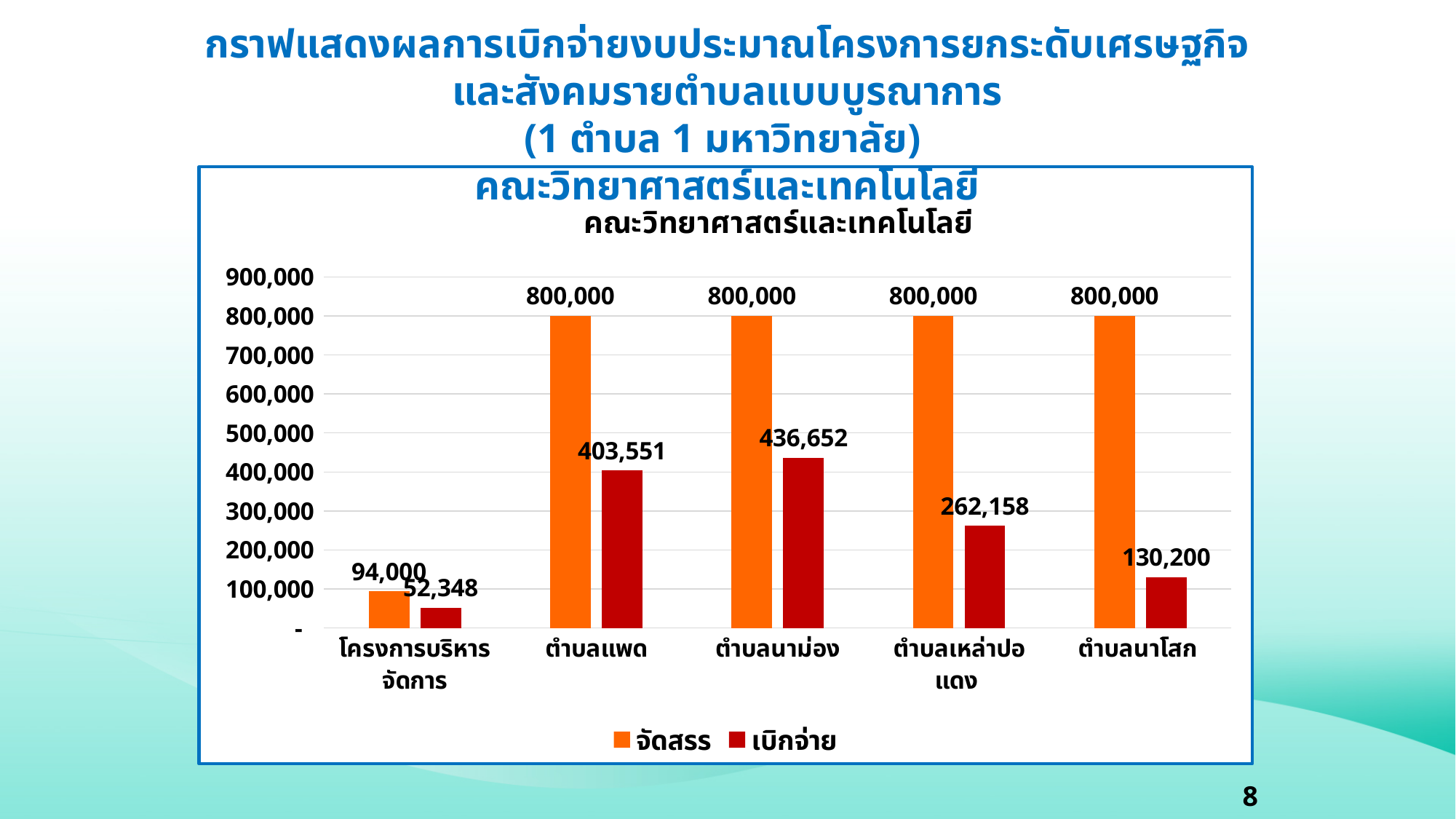
What kind of chart is shown on the slide? bar chart How many series does the legend list? 2 How many categories are shown on the x axis? 5 What is the จัดสรร value for โครงการบริหารจัดการ? 94,000 Is the เบิกจ่าย value for ตำบลแพด greater or less than 500,000? less Which is larger, the เบิกจ่าย value for ตำบลเหล่าปอแดง or for ตำบลนาโสก? ตำบลเหล่าปอแดง What is the difference between the จัดสรร and เบิกจ่าย values for ตำบลแพด? 396,449 Which series is shown in orange? จัดสรร Which category has the lowest เบิกจ่าย value? โครงการบริหารจัดการ What is the เบิกจ่าย value for ตำบลนาโสก? 130,200 What is the เบิกจ่าย value for ตำบลนาม่อง? 436,652 Which category has the highest เบิกจ่าย value? ตำบลนาม่อง